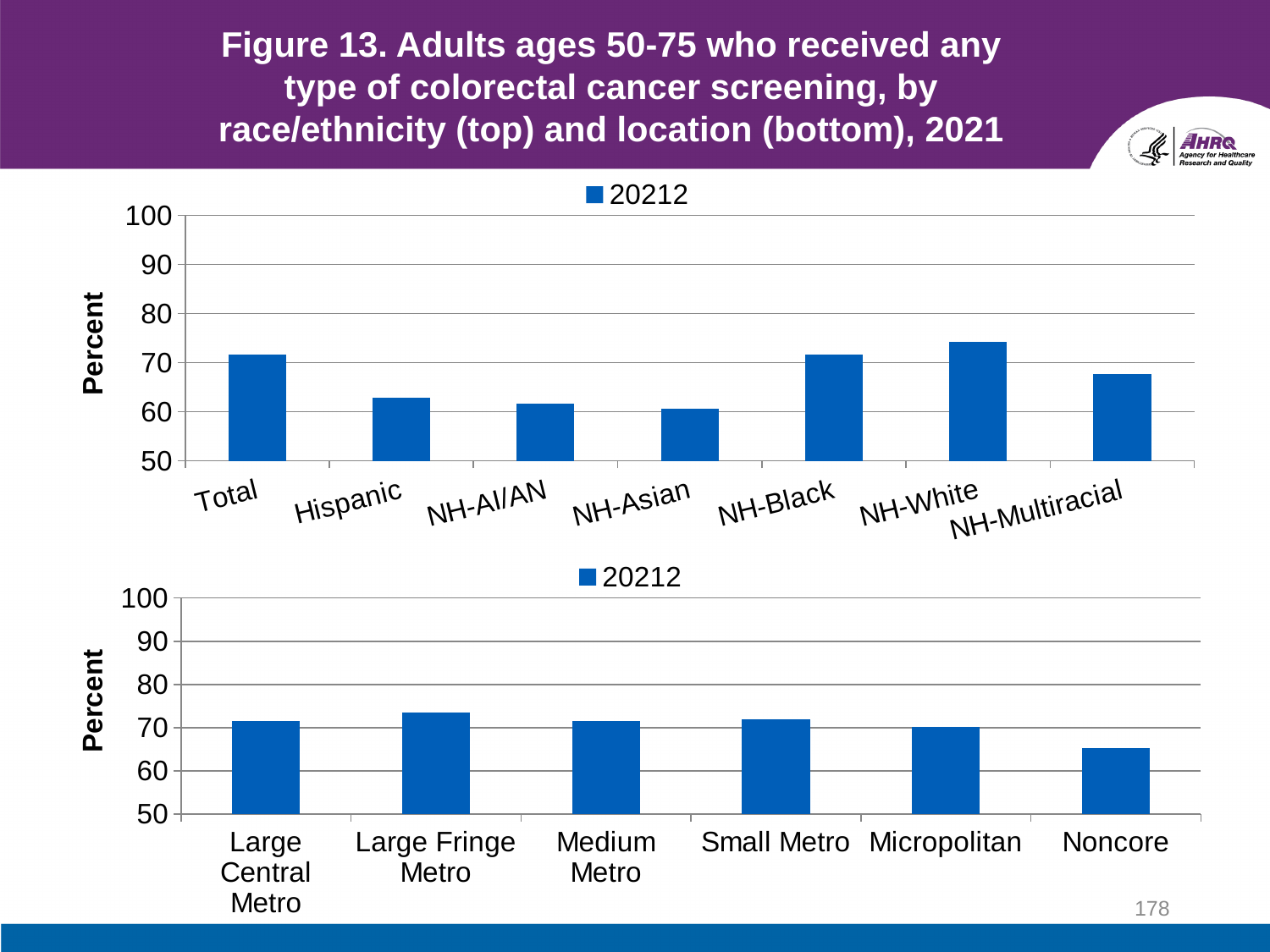
What is the label on the y axis of the bottom chart? Percent In the bottom chart (location), is the value for Noncore greater or less than 70? less How many series does the legend of the top chart list? 1 How many categories are shown on the x axis of the top chart (race/ethnicity)? 7 In the top chart (race/ethnicity), is the value for NH-White greater or less than 70? greater In the top chart (race/ethnicity), which category has the highest value? NH-White In the top chart (race/ethnicity), which is larger, the value for NH-Black or the value for NH-Asian? NH-Black How many categories are shown on the x axis of the bottom chart (location)? 6 In the bottom chart (location), which is larger, the value for Large Central Metro or the value for Noncore? Large Central Metro In the bottom chart (location), which category has the lowest value? Noncore What type of chart is the top chart on the slide? bar chart In the top chart (race/ethnicity), is the value for Hispanic greater or less than 70? less